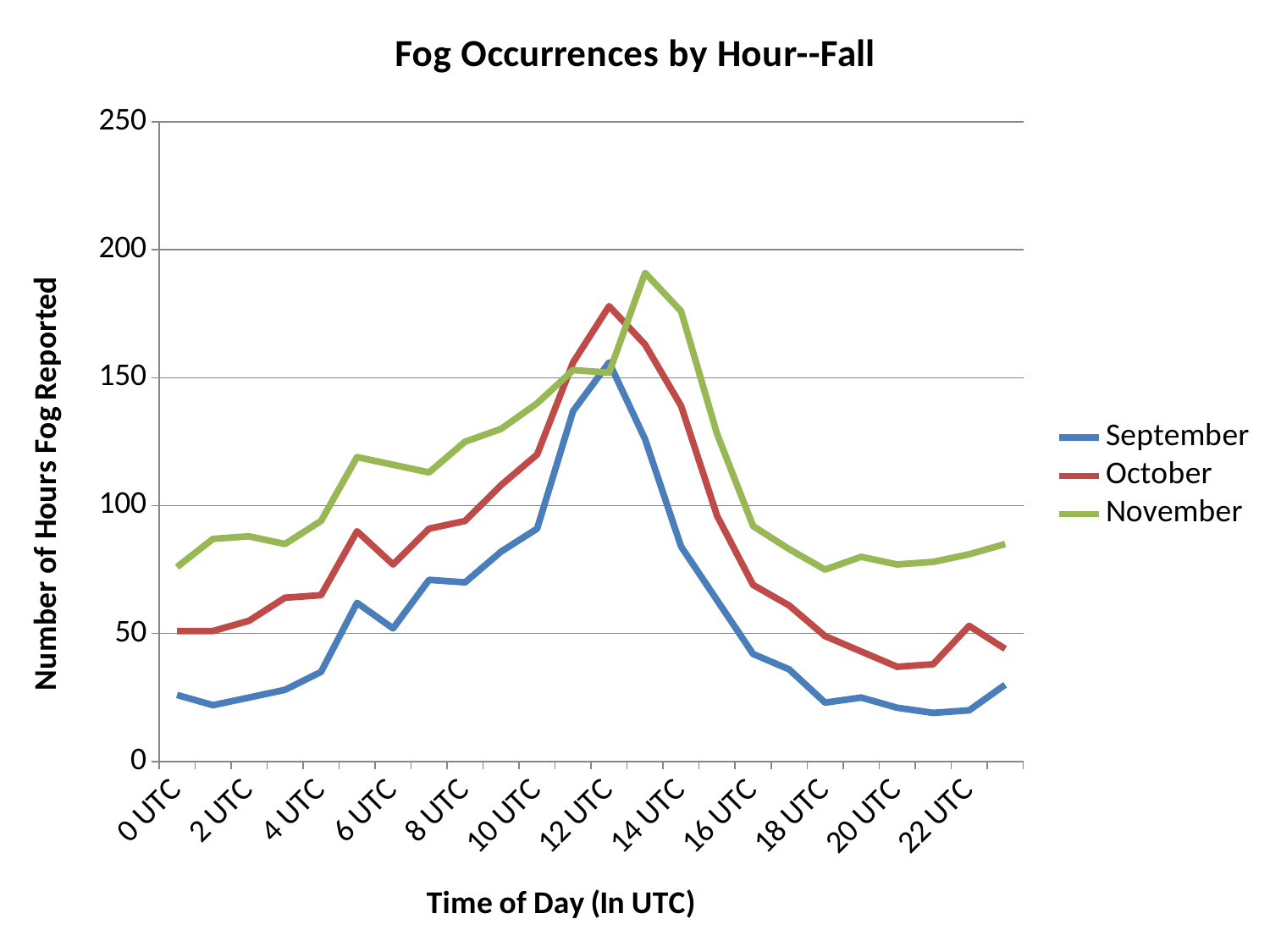
Which series has the lowest values across the day? September What kind of chart is shown on the slide? line chart Is the value for October at 12 UTC greater or less than 150? greater Is the value for September at 22 UTC greater or less than 50? less At 12 UTC, which is larger: the value for October or the value for November? October Does the September line rise or fall between 12 UTC and 18 UTC? fall Is the value for November at 0 UTC greater or less than 50? greater How many series does the legend list? 3 Which series reaches the highest peak value on the chart? November What is the title of the chart? Fog Occurrences by Hour--Fall At 14 UTC, which is larger: the value for November or the value for October? November